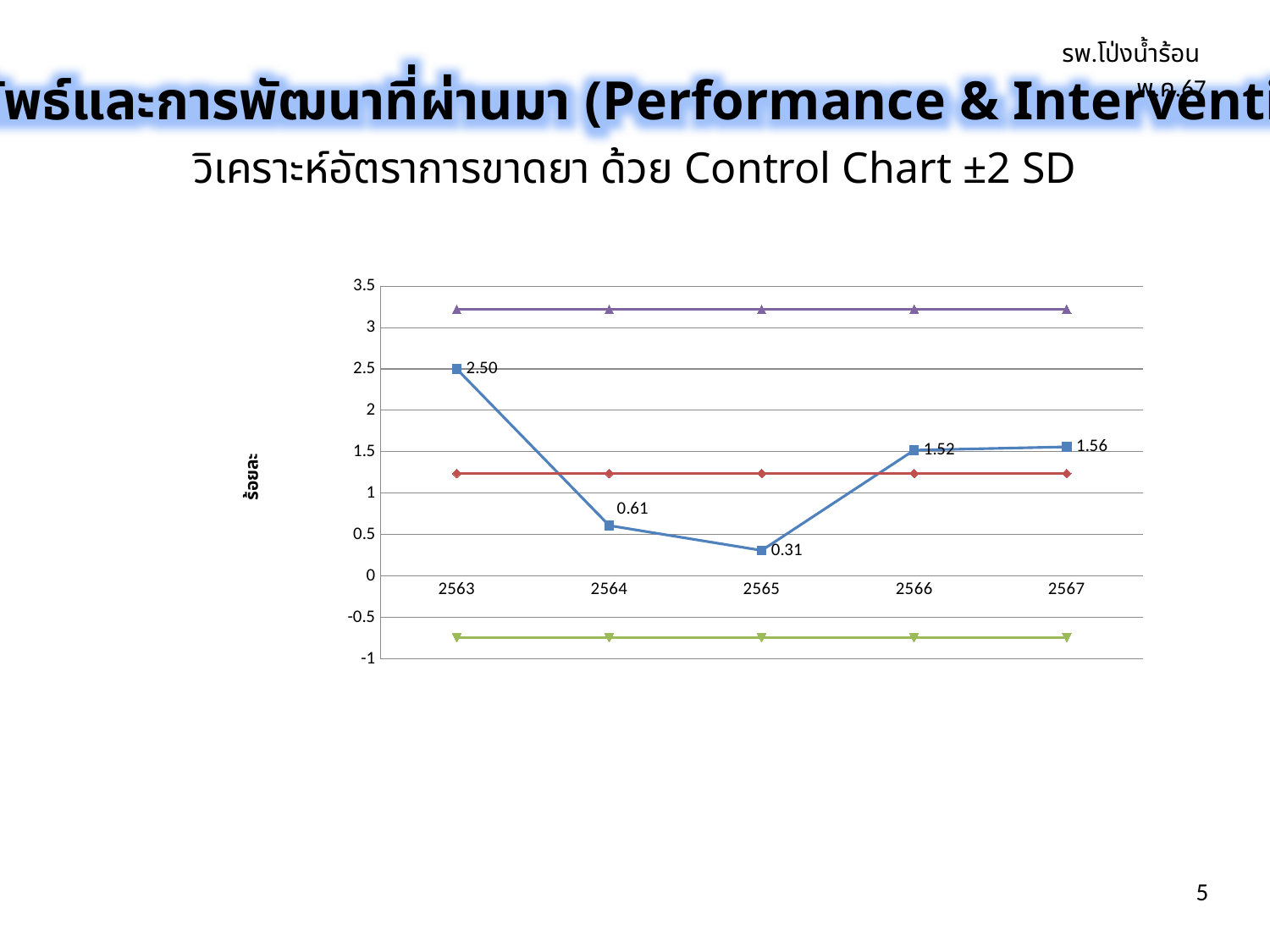
What kind of chart is shown on the slide? line chart What is the value of the data line for 2567? 1.56 Which is larger, the value for 2564 or the value for 2566? 2566 What is the value of the data line for 2563? 2.50 Is the upper control limit line (purple) greater or less than 3? greater Which year has the highest value on the labelled data line? 2563 What is the value of the data line for 2564? 0.61 What is the label of the y axis? ร้อยละ Which year has the lowest value on the labelled data line? 2565 What is the value of the data line for 2565? 0.31 What is the difference between the values for 2563 and 2565? 2.19 How many years are shown on the x axis? 5